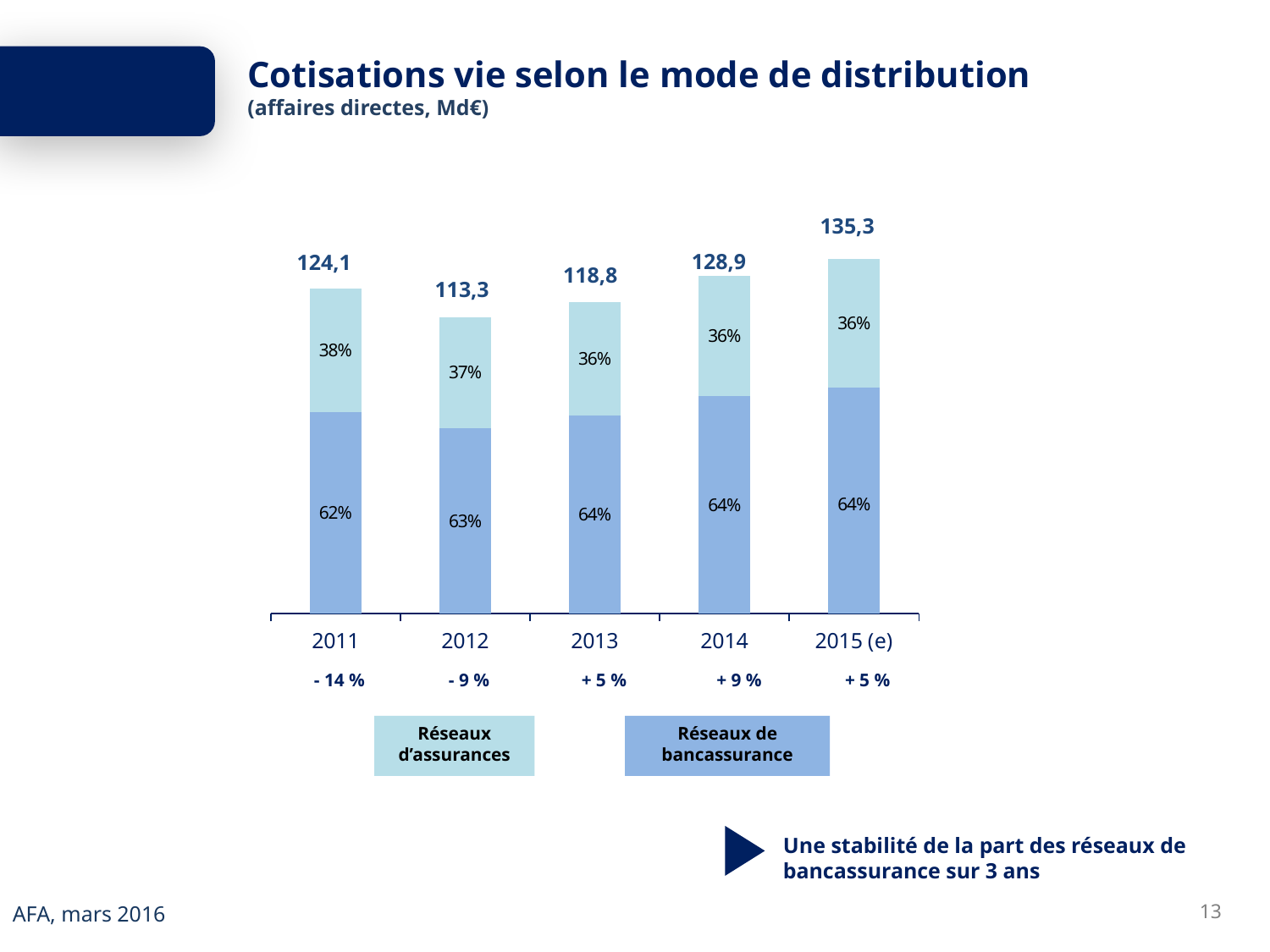
What share of the 2013 bar is labelled for Réseaux de bancassurance? 64% How many years are shown on the x axis? 5 Which year has the highest total value? 2015 (e) What growth rate is printed below the 2014 bar? + 9 % What is the total value shown above the bar for 2015 (e)? 135,3 What is the difference between the total for 2015 (e) and the total for 2014? 6,4 How many series does the legend list? 2 Which year has the lowest total value? 2012 What is the total value shown above the bar for 2011? 124,1 What kind of chart is shown on the slide? Stacked bar chart What share of the 2011 bar is labelled for Réseaux d'assurances? 38% Which is larger, the total for 2011 or the total for 2013? 2011